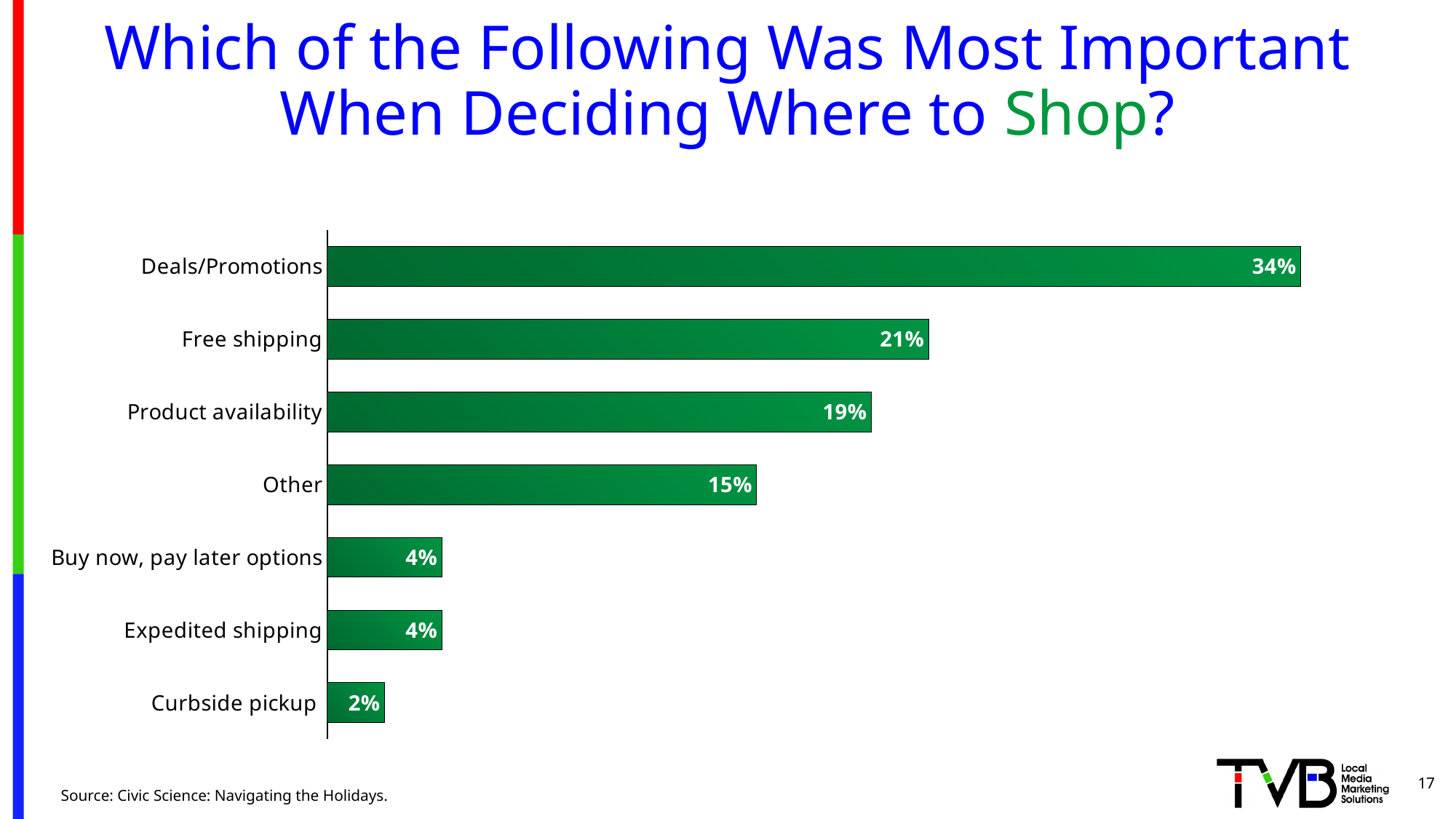
What is the value shown for Curbside pickup? 2% What is the value shown for Product availability? 19% What is the difference between the values for Deals/Promotions and Free shipping? 13 percentage points Which is larger, the value for Product availability or the value for Other? Product availability What is the value shown for Free shipping? 21% What is the source cited at the bottom of the slide? Civic Science: Navigating the Holidays. How many categories are shown in the chart? 7 Which category has the highest value? Deals/Promotions What is the difference between the values for Other and Buy now, pay later options? 11 percentage points Which category has the lowest value? Curbside pickup What percentage of respondents said Deals/Promotions was most important when deciding where to shop? 34% What kind of chart is shown on the slide? Bar chart